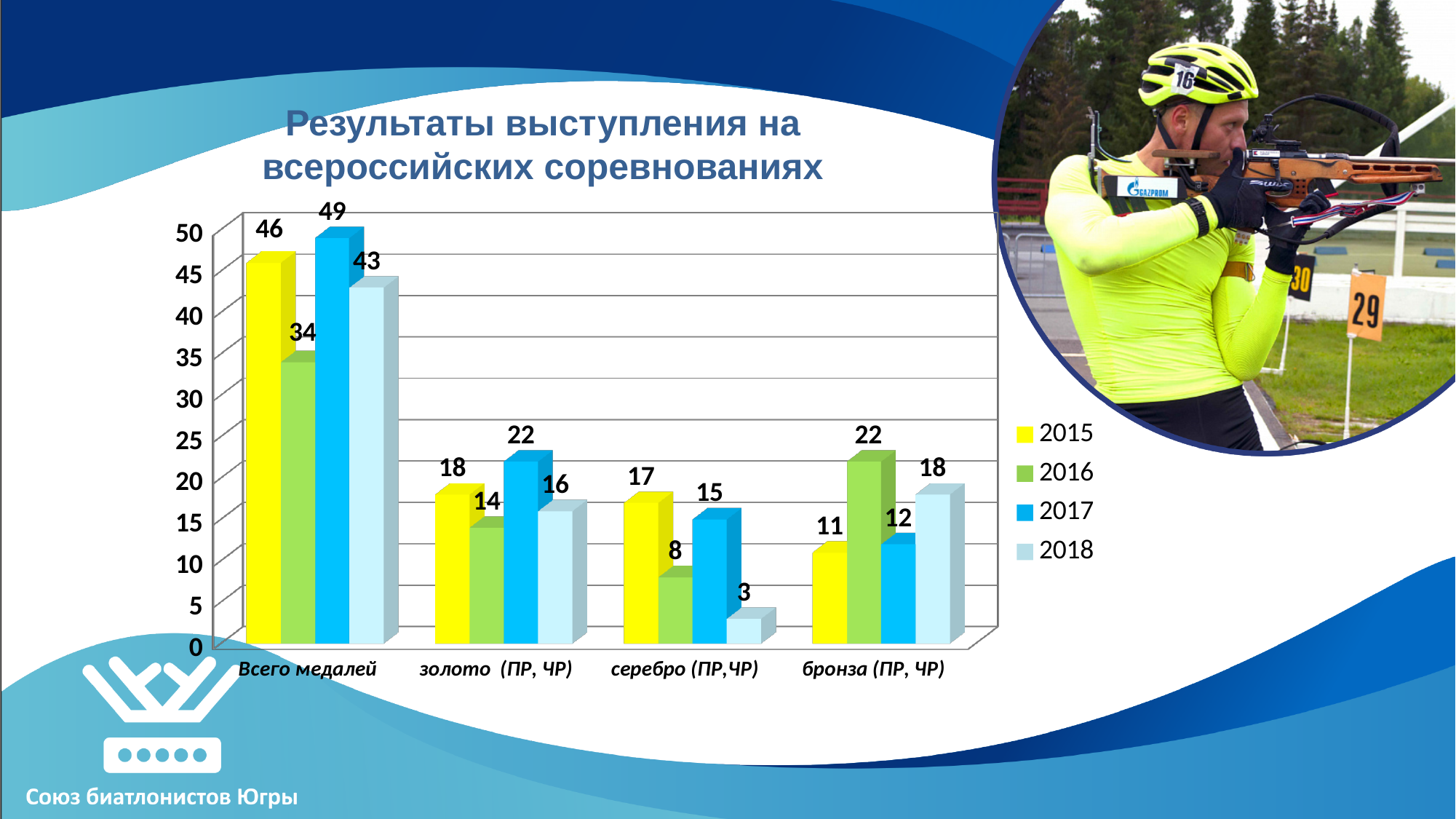
How many series does the legend list? 4 Which year has the lowest value in the "серебро (ПР,ЧР)" category? 2018 How many categories are shown on the x axis of the chart? 4 What is the value for 2016 in the "серебро (ПР,ЧР)" category? 8 Which year is represented by the yellow bars in the chart? 2015 Which is larger in the "бронза (ПР, ЧР)" category: the value for 2016 or the value for 2015? 2016 What is the difference between the 2017 and 2016 values in the "золото (ПР, ЧР)" category? 8 What is the value for 2018 in the "бронза (ПР, ЧР)" category? 18 Which year has the highest value in the "Всего медалей" category? 2017 What kind of chart is shown on the slide? Bar chart What is the title of the chart? Результаты выступления на всероссийских соревнованиях What is the value for 2017 in the "Всего медалей" category? 49